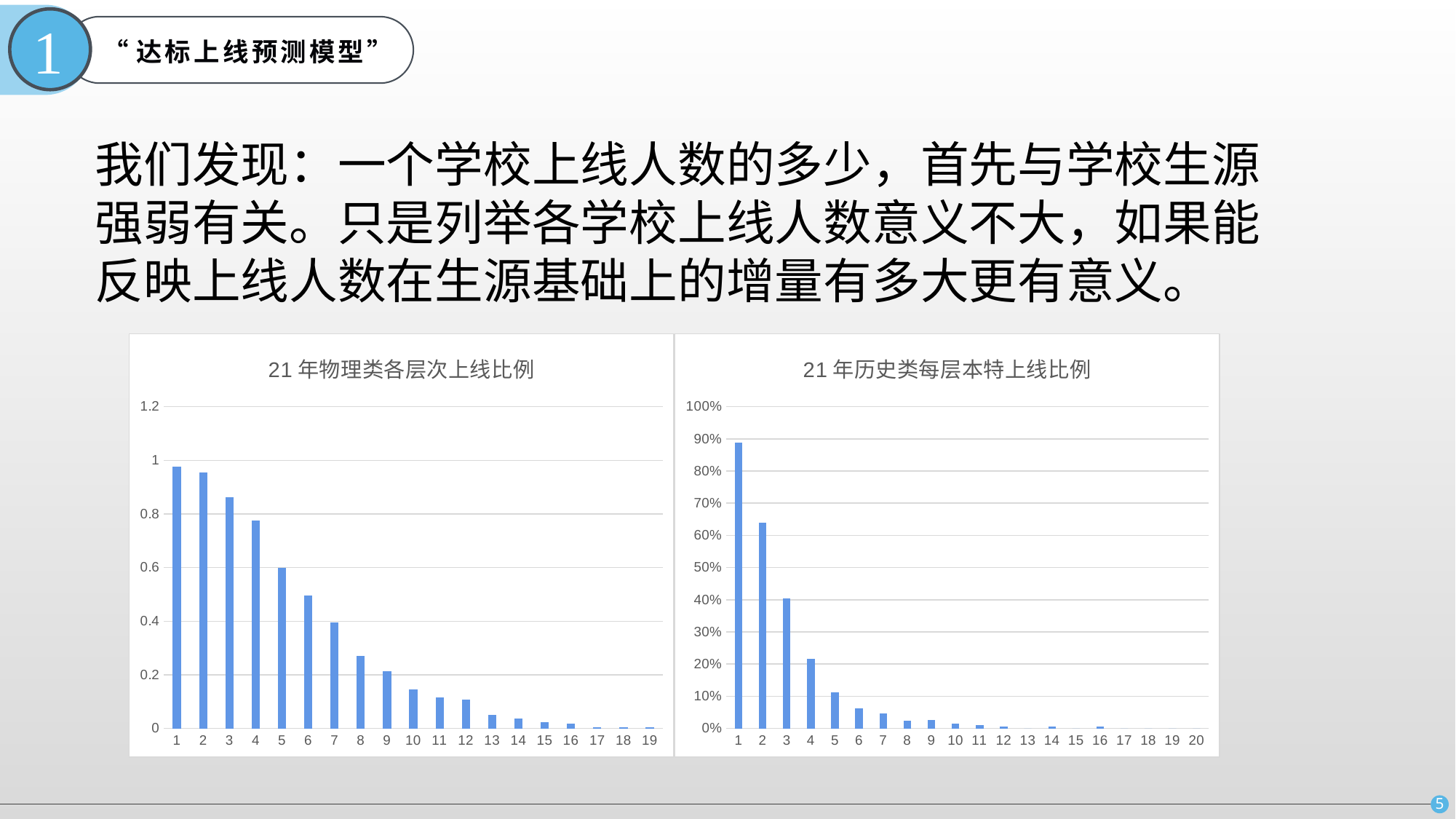
How many categories are shown on the x axis of the left chart "21 年物理类各层次上线比例"? 19 In the right chart "21 年历史类每层本特上线比例", is the value for category 3 greater or less than 50%? less In the left chart "21 年物理类各层次上线比例", is the value for category 3 greater or less than 0.8? greater In the right chart "21 年历史类每层本特上线比例", which is larger, the value for category 2 or the value for category 4? category 2 In the right chart "21 年历史类每层本特上线比例", is the value for category 1 greater or less than 80%? greater What is the title of the right chart on the slide? 21 年历史类每层本特上线比例 In the left chart "21 年物理类各层次上线比例", which category has the highest value? 1 What kind of chart is the left chart titled "21 年物理类各层次上线比例"? bar chart How many categories are shown on the x axis of the right chart "21 年历史类每层本特上线比例"? 20 In the left chart "21 年物理类各层次上线比例", do the values rise or fall as you move from category 1 to category 19? fall In the right chart "21 年历史类每层本特上线比例", which category has the highest value? 1